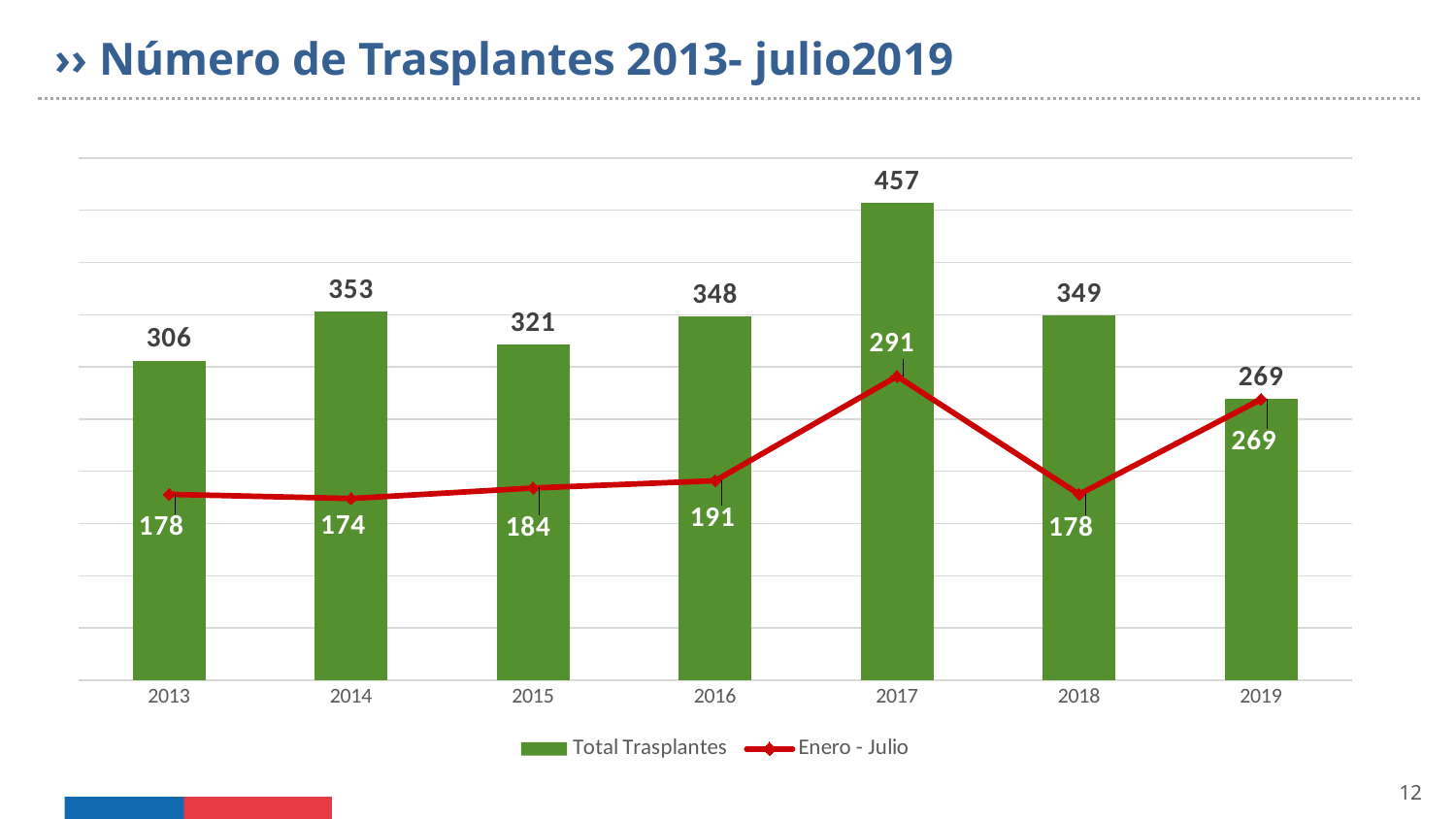
What is the Total Trasplantes value for 2013? 306 Which year has the lowest Enero - Julio value? 2014 What colour are the Total Trasplantes bars? Green What is the difference between the Total Trasplantes values for 2017 and 2018? 108 What is the Enero - Julio value for 2015? 184 What kind of chart is shown on the slide? Combined bar and line chart Does the Enero - Julio series rise or fall from 2018 to 2019? Rise What is the Total Trasplantes value for 2017? 457 Which is larger, the Enero - Julio value for 2017 or for 2019? 2017 How many years are shown on the x axis? 7 How many series does the legend list? 2 Which year has the highest Total Trasplantes value? 2017